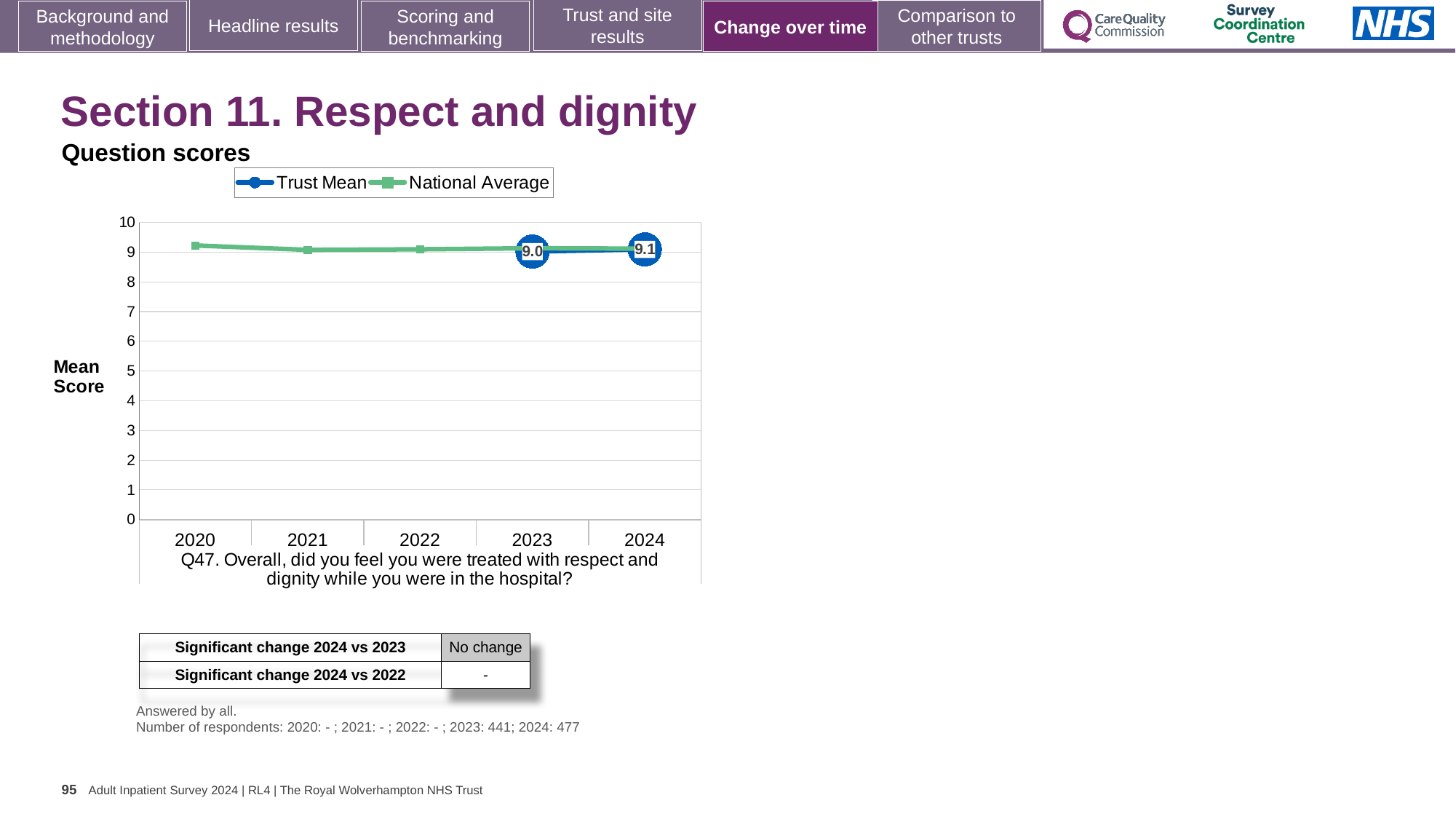
How many years are shown on the x axis of the chart? 5 Is the National Average value for 2020 greater or less than 8? greater What is the Trust Mean score for 2024? 9.1 What is the label on the y axis of the chart? Mean Score How many series does the chart legend list? 2 What kind of chart is shown on the slide? Line chart Is the National Average value for 2021 greater or less than 5? greater Which year has the higher Trust Mean score, 2023 or 2024? 2024 What is the Trust Mean score for 2023? 9.0 Does the Trust Mean rise or fall from 2023 to 2024? Rise How many data points are plotted for the Trust Mean series? 2 What is the difference between the Trust Mean scores for 2024 and 2023? 0.1